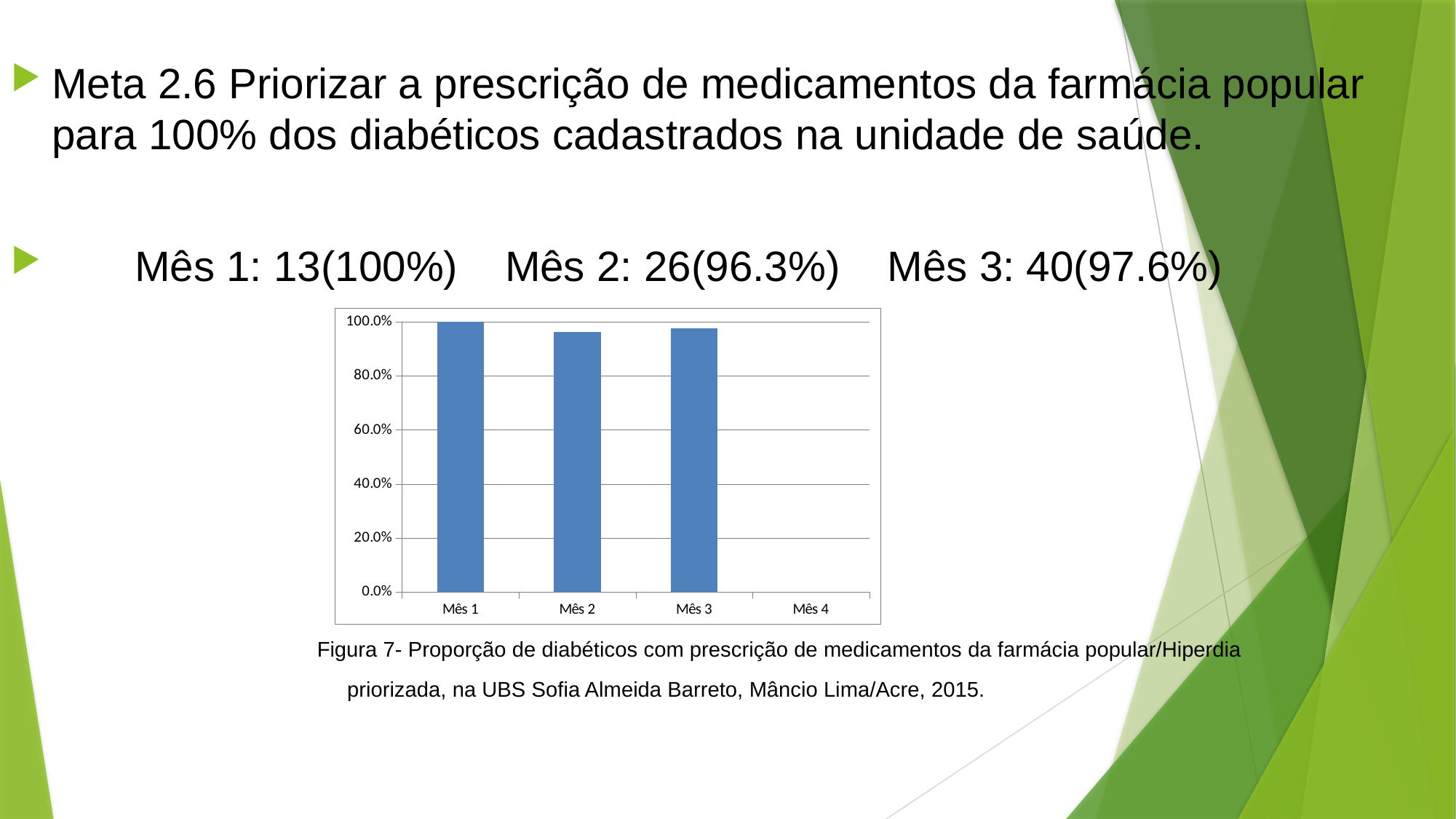
What is the value for Mês 3 in the chart? 97.6% What is the value for Mês 2 in the chart? 96.3% Is the value for Mês 2 greater or less than 80.0%? greater How many bars are plotted in the chart? 3 Is the value for Mês 3 greater or less than 60.0%? greater What kind of chart is shown on the slide? bar chart What is the difference between the values for Mês 1 and Mês 2? 3.7 percentage points What is the highest tick value shown on the y axis of the chart? 100.0% Which category on the x axis has no bar plotted? Mês 4 What is the value for Mês 1 in the chart? 100% How many categories are shown on the x axis of the chart? 4 Which month has the highest bar in the chart? Mês 1